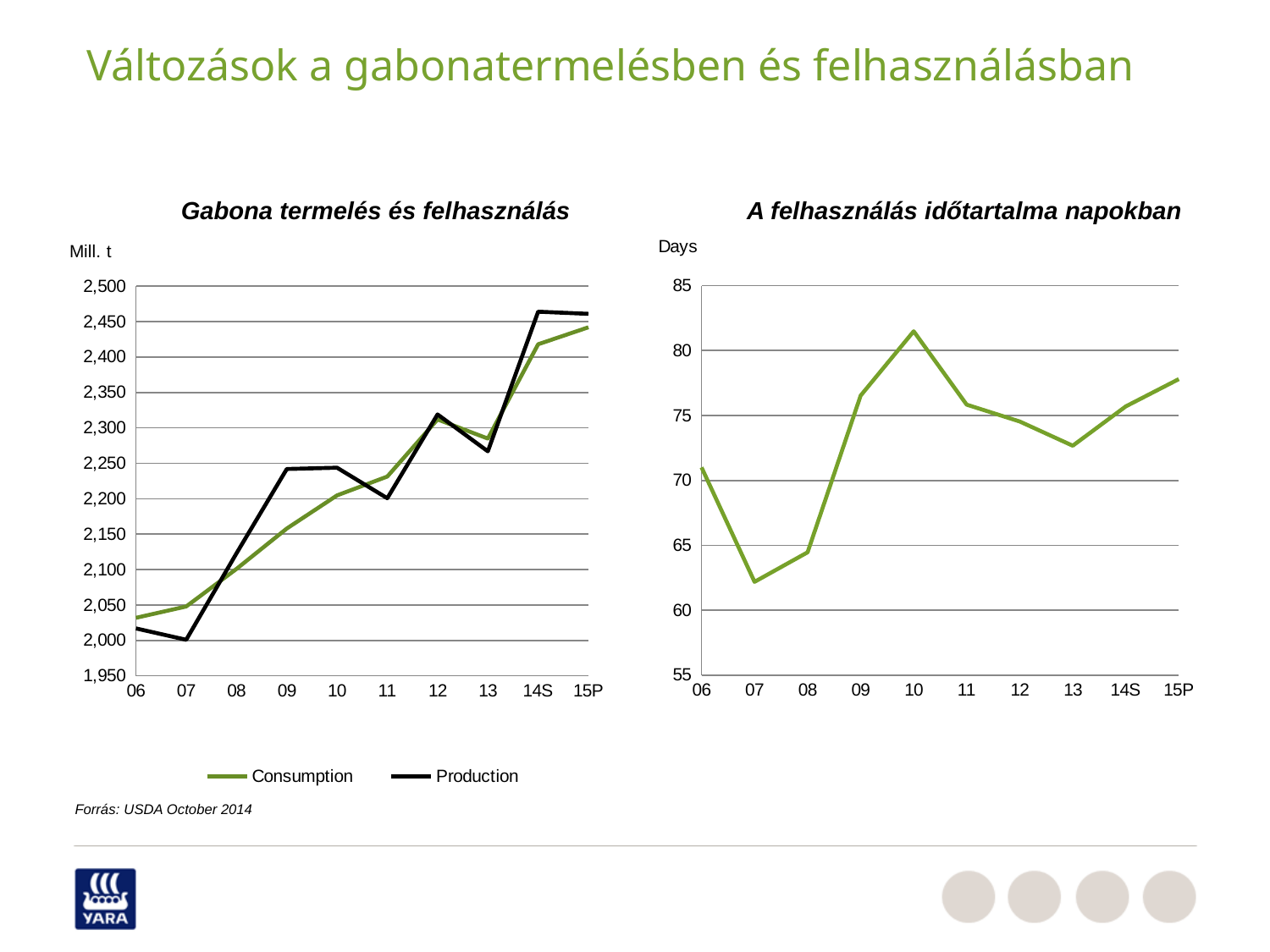
In the right chart 'A felhasználás időtartalma napokban', in which year is the value lowest? 07 How many series does the legend of the left chart 'Gabona termelés és felhasználás' list? 2 In the right chart 'A felhasználás időtartalma napokban', in which year is the value highest? 10 How many points are plotted along the x axis of the right chart 'A felhasználás időtartalma napokban'? 10 In the left chart 'Gabona termelés és felhasználás', which series is higher in 09, Consumption or Production? Production In the left chart 'Gabona termelés és felhasználás', in which year is Production lowest? 07 In the left chart 'Gabona termelés és felhasználás', is the Consumption value for 15P greater or less than 2,450? less In the right chart 'A felhasználás időtartalma napokban', is the value for 13 greater or less than 75? less In the left chart 'Gabona termelés és felhasználás', in which year is Production highest? 14S In the left chart 'Gabona termelés és felhasználás', what unit is shown on the y axis? Mill. t What kind of chart is the left chart titled 'Gabona termelés és felhasználás'? line chart In the left chart 'Gabona termelés és felhasználás', is the Production value for 14S greater or less than 2,450? greater